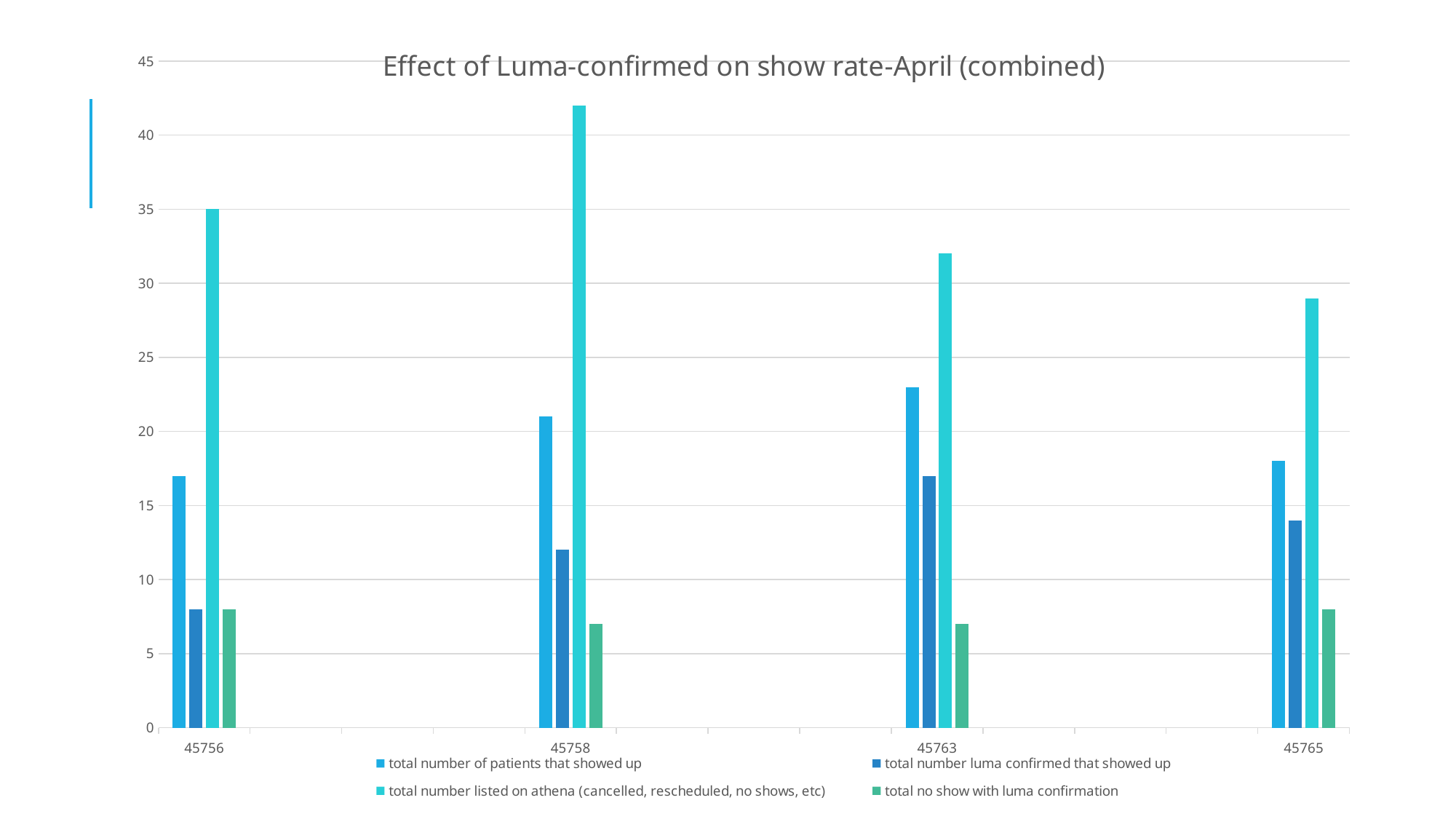
Is the value for 'total number listed on athena (cancelled, rescheduled, no shows, etc)' at 45758 greater or less than 40? greater Which is larger at 45763: 'total number of patients that showed up' or 'total number luma confirmed that showed up'? total number of patients that showed up How many categories are shown on the x axis? 4 Is the value for 'total number of patients that showed up' at 45758 greater or less than 20? greater What is the title of the chart? Effect of Luma-confirmed on show rate-April (combined) Which category has the highest value for 'total number listed on athena (cancelled, rescheduled, no shows, etc)'? 45758 What is the value of 'total number listed on athena (cancelled, rescheduled, no shows, etc)' for 45756? 35 Which category has the lowest value for 'total number listed on athena (cancelled, rescheduled, no shows, etc)'? 45765 How many series does the legend list? 4 Is the value for 'total number luma confirmed that showed up' at 45756 greater or less than 10? less What kind of chart is shown on the slide? bar chart Which category has the highest value for 'total number of patients that showed up'? 45763